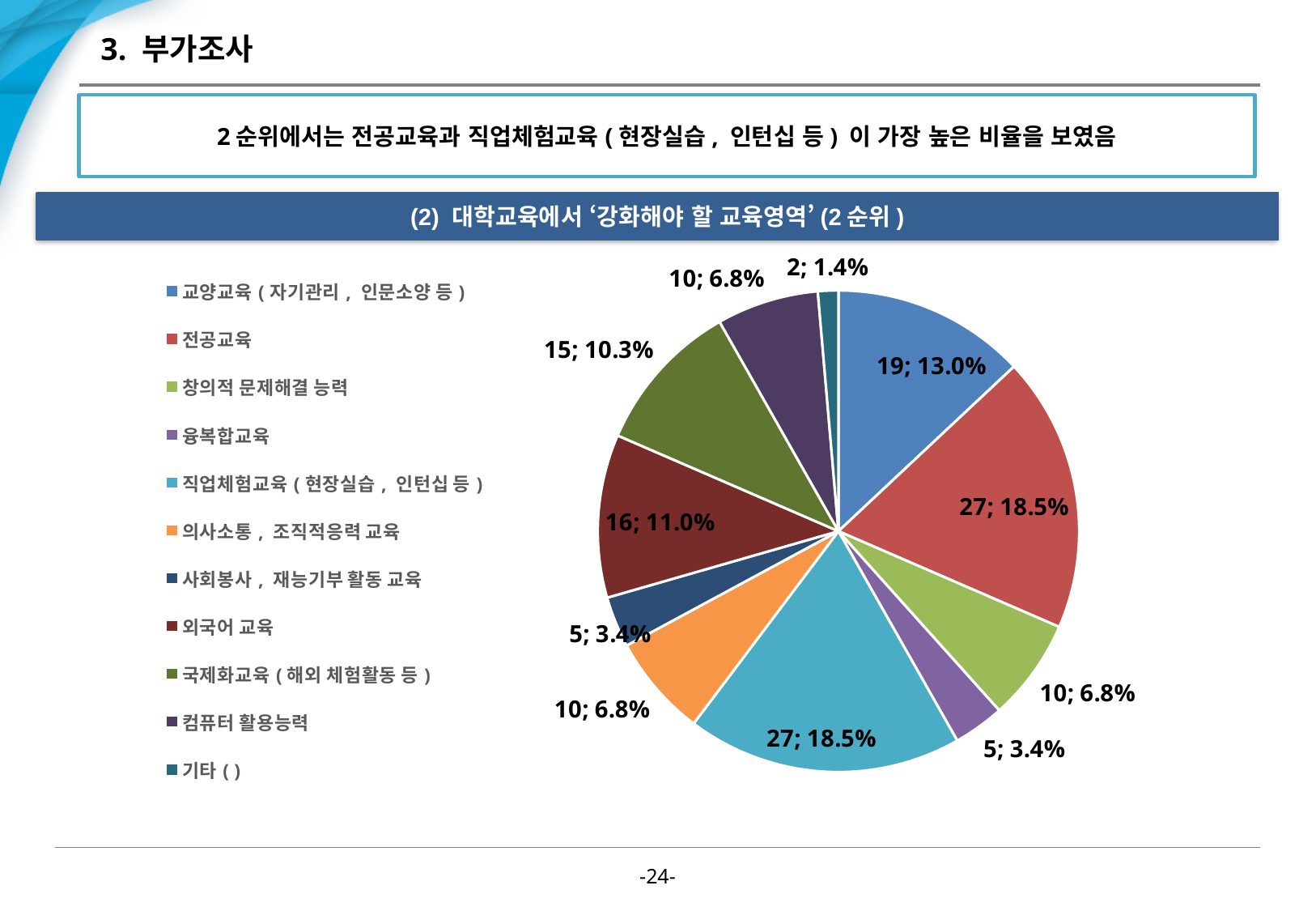
What share of the pie does 컴퓨터 활용능력 represent? 6.8% What is the count and percentage shown for 전공교육? 27; 18.5% Which category has the smallest slice of the pie? 기타 ( ) Which has a larger count, 외국어 교육 or 국제화교육 (해외 체험활동 등)? 외국어 교육 What is the count and percentage shown for 교양교육 (자기관리, 인문소양 등)? 19; 13.0% What share of the pie does 직업체험교육 (현장실습, 인턴십 등) represent? 18.5% What is the count and percentage shown for 외국어 교육? 16; 11.0% How many categories does the pie chart have? 11 What kind of chart is shown on the slide? pie chart What colour is the slice for 전공교육? red What is the difference in count between 교양교육 (자기관리, 인문소양 등) and 외국어 교육? 3 What is the count and percentage shown for 국제화교육 (해외 체험활동 등)? 15; 10.3%